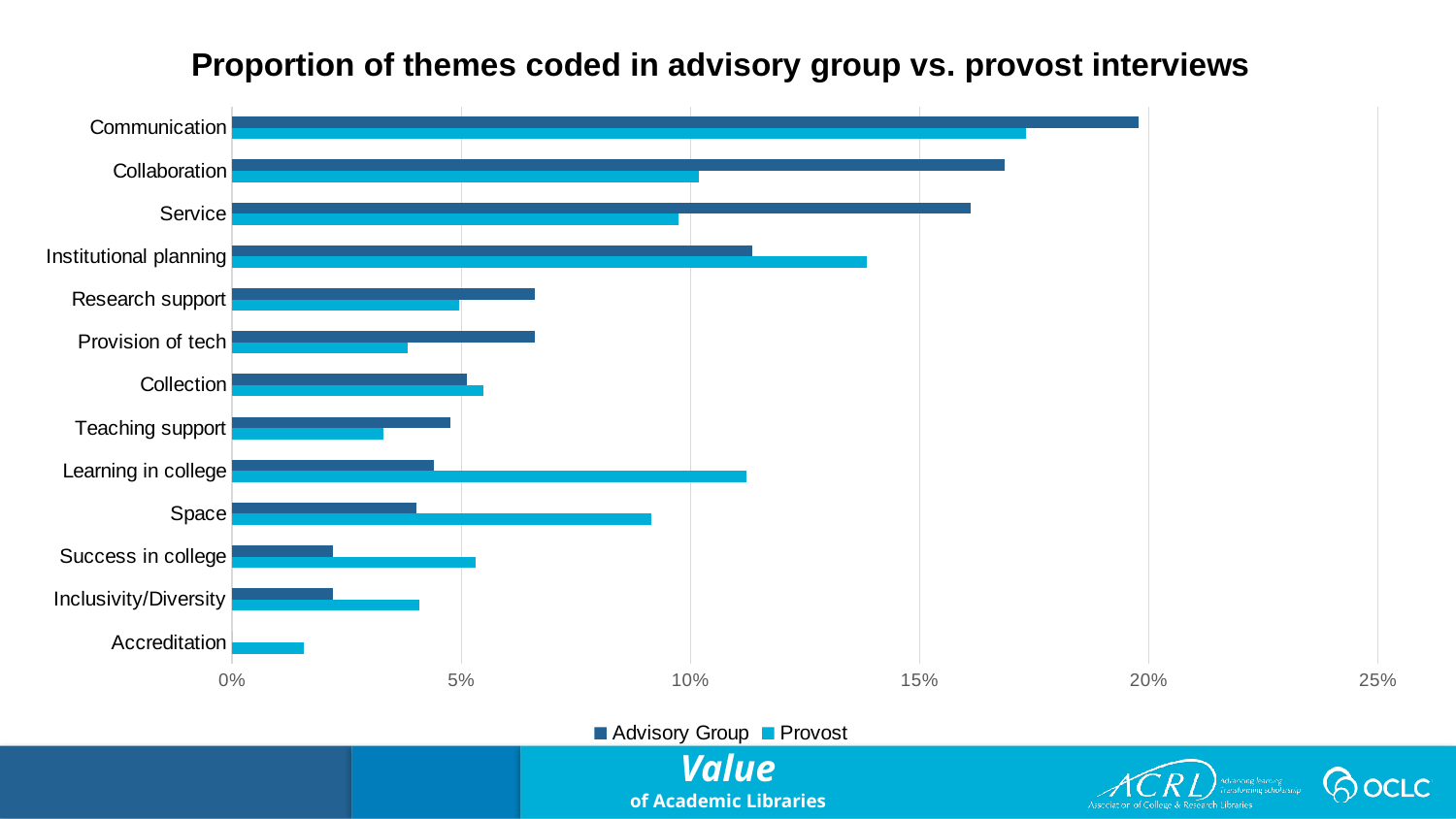
Is the Provost value for Institutional planning greater or less than 10%? greater Is the Advisory Group value for Communication greater or less than 15%? greater What kind of chart is shown on the slide? bar chart Which theme has the highest Provost value? Communication For Collaboration, which series has the larger value, Advisory Group or Provost? Advisory Group How many theme categories are plotted on the chart? 13 Which theme has the highest Advisory Group value? Communication For Institutional planning, which series has the larger value, Advisory Group or Provost? Provost What is the title of the chart? Proportion of themes coded in advisory group vs. provost interviews Which theme has the lowest Provost value? Accreditation Is the Advisory Group value for Success in college greater or less than 5%? less How many series does the legend list? 2